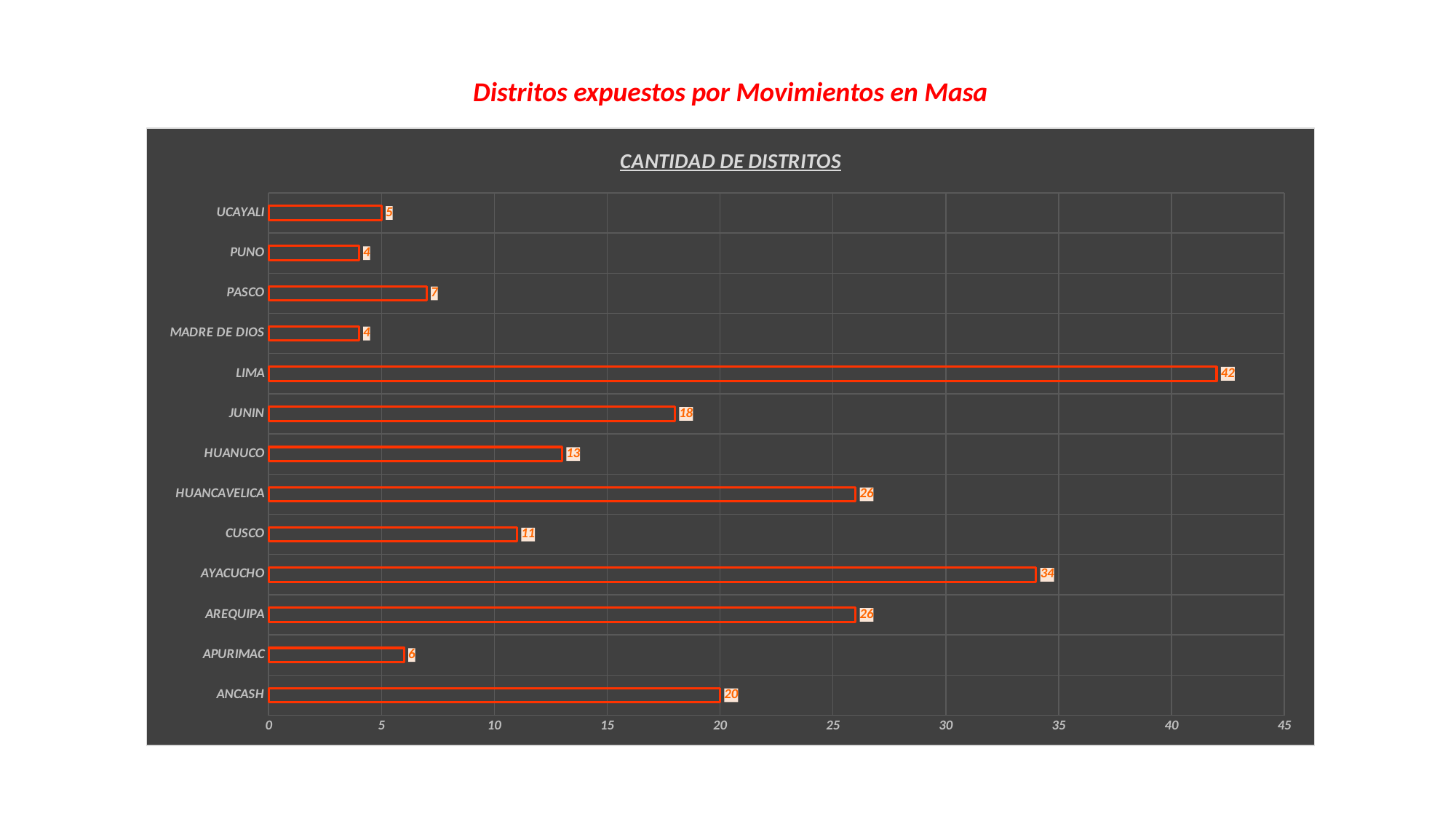
Is the value for ANCASH greater or less than 15? greater What is the value for APURIMAC? 6 What kind of chart is shown on the slide? bar chart What is the title of the chart? CANTIDAD DE DISTRITOS What is the value for PASCO? 7 What is the value for HUANCAVELICA? 26 What is the difference between the values for AREQUIPA and CUSCO? 15 What is the value for LIMA? 42 Which category has the highest value? LIMA Which is larger, the value for JUNIN or the value for HUANUCO? JUNIN What is the difference between the values for LIMA and AYACUCHO? 8 How many categories are shown in the chart? 13